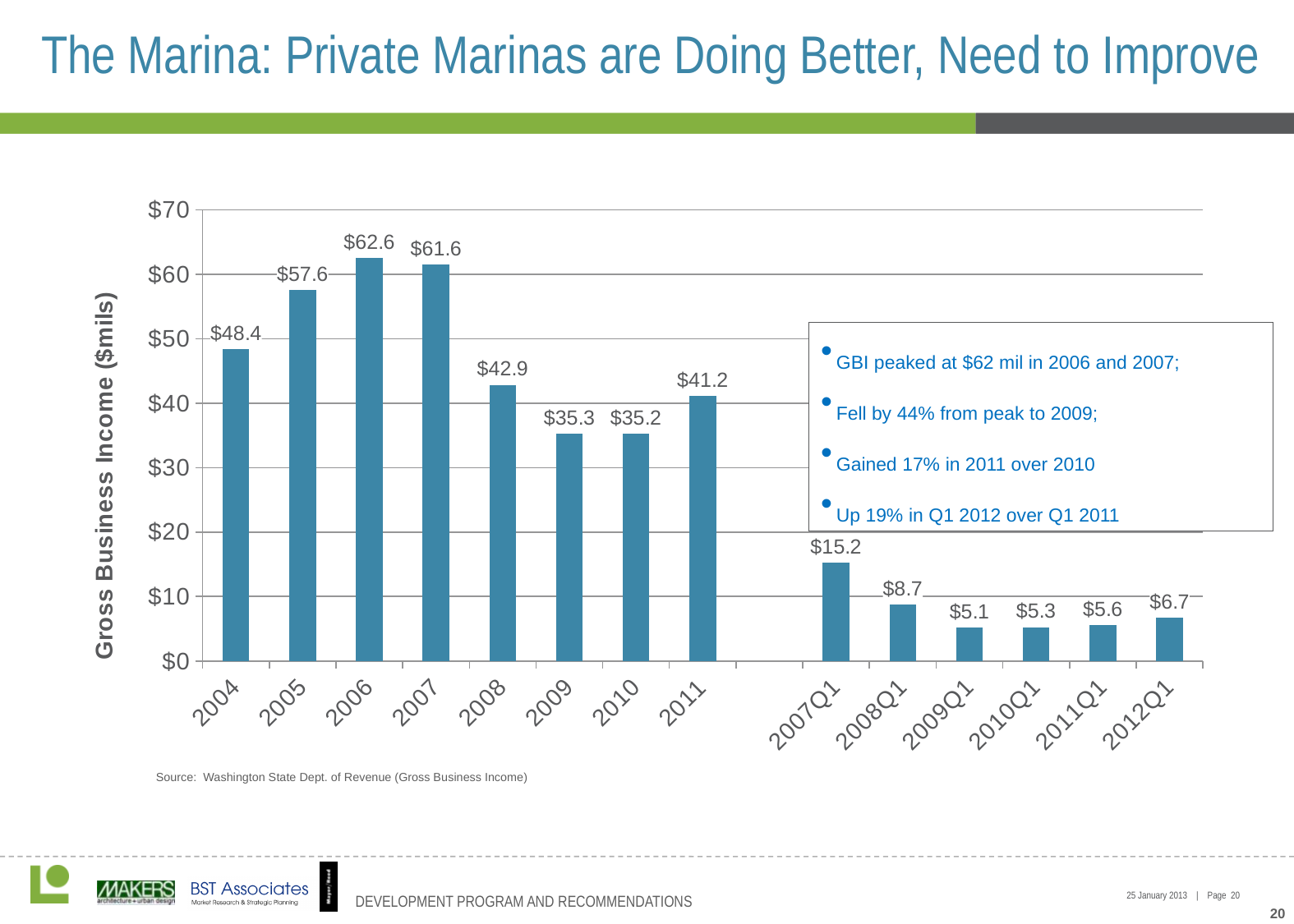
What is the label of the vertical axis? Gross Business Income ($mils) What is the difference in Gross Business Income between 2007 and 2008? $18.7 Which year or quarter has the highest Gross Business Income? 2006 What is the difference in Gross Business Income between 2007Q1 and 2008Q1? $6.5 What is the Gross Business Income for 2006? $62.6 What is the Gross Business Income for 2012Q1? $6.7 Which year or quarter has the lowest Gross Business Income? 2009Q1 How many bars are plotted in the chart? 14 What kind of chart is shown on the slide? Bar chart What is the Gross Business Income for 2009? $35.3 Is the Gross Business Income for 2004 greater or less than $40? greater Which has a higher Gross Business Income, 2005 or 2011? 2005